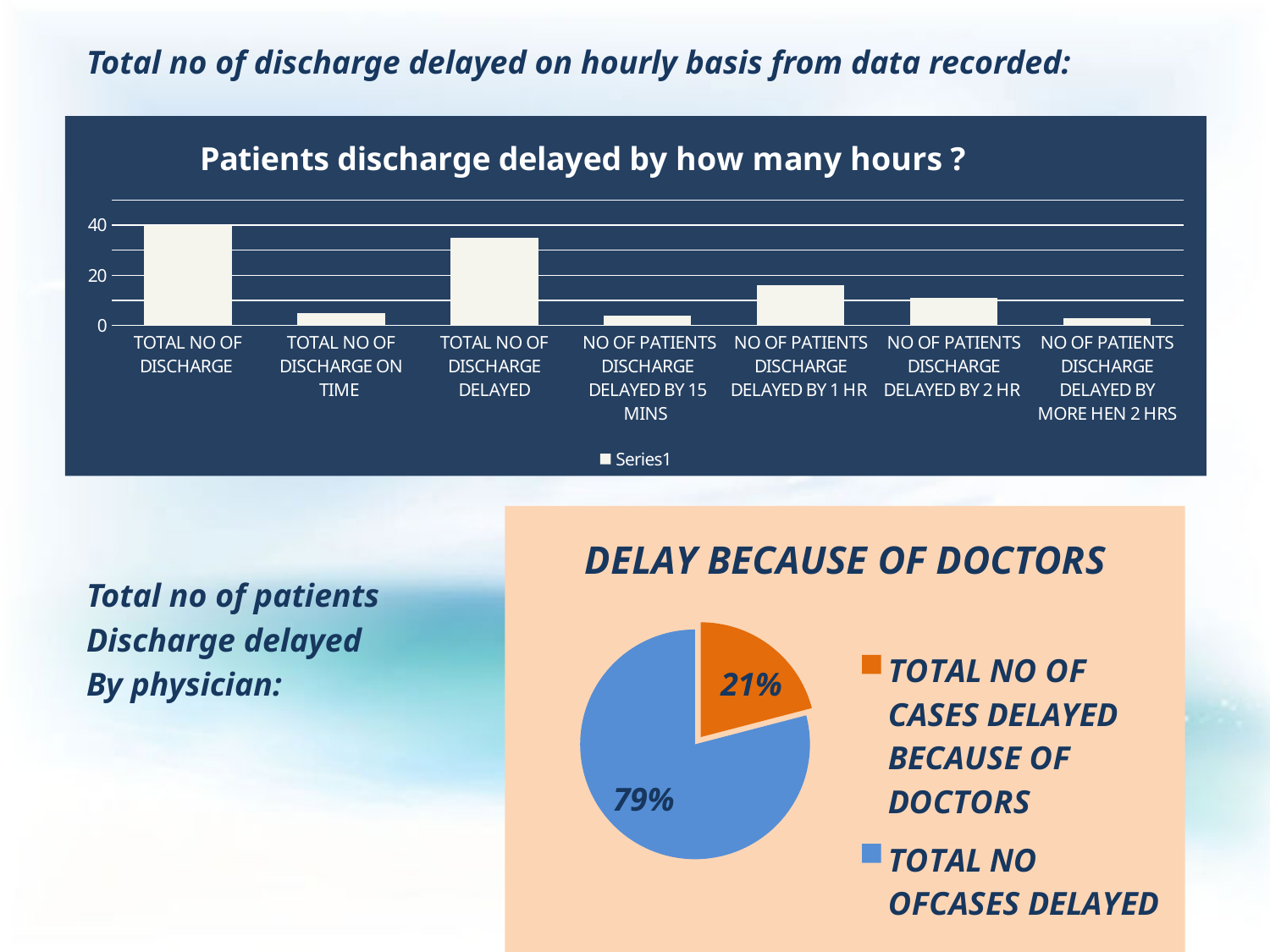
In the chart titled "Patients discharge delayed by how many hours ?", which category has the highest bar? TOTAL NO OF DISCHARGE In the pie chart titled "DELAY BECAUSE OF DOCTORS", what colour is the slice for TOTAL NO OF CASES DELAYED BECAUSE OF DOCTORS? Orange In the chart titled "Patients discharge delayed by how many hours ?", which is larger: TOTAL NO OF DISCHARGE ON TIME or TOTAL NO OF DISCHARGE DELAYED? TOTAL NO OF DISCHARGE DELAYED In the pie chart titled "DELAY BECAUSE OF DOCTORS", what share is labelled for TOTAL NO OF CASES DELAYED BECAUSE OF DOCTORS? 21% In the chart titled "Patients discharge delayed by how many hours ?", is the value for NO OF PATIENTS DISCHARGE DELAYED BY 1 HR greater or less than 20? less In the chart titled "Patients discharge delayed by how many hours ?", which is larger: NO OF PATIENTS DISCHARGE DELAYED BY 1 HR or NO OF PATIENTS DISCHARGE DELAYED BY 2 HR? NO OF PATIENTS DISCHARGE DELAYED BY 1 HR In the chart titled "Patients discharge delayed by how many hours ?", what kind of chart is shown? Bar chart In the chart titled "Patients discharge delayed by how many hours ?", how many categories are plotted? 7 In the pie chart titled "DELAY BECAUSE OF DOCTORS", what share is labelled for TOTAL NO OFCASES DELAYED? 79% In the chart titled "Patients discharge delayed by how many hours ?", how many series does the legend list? 1 In the pie chart titled "DELAY BECAUSE OF DOCTORS", what is the difference in percentage points between the two slices? 58 In the chart titled "Patients discharge delayed by how many hours ?", is the value for TOTAL NO OF DISCHARGE DELAYED greater or less than 20? greater